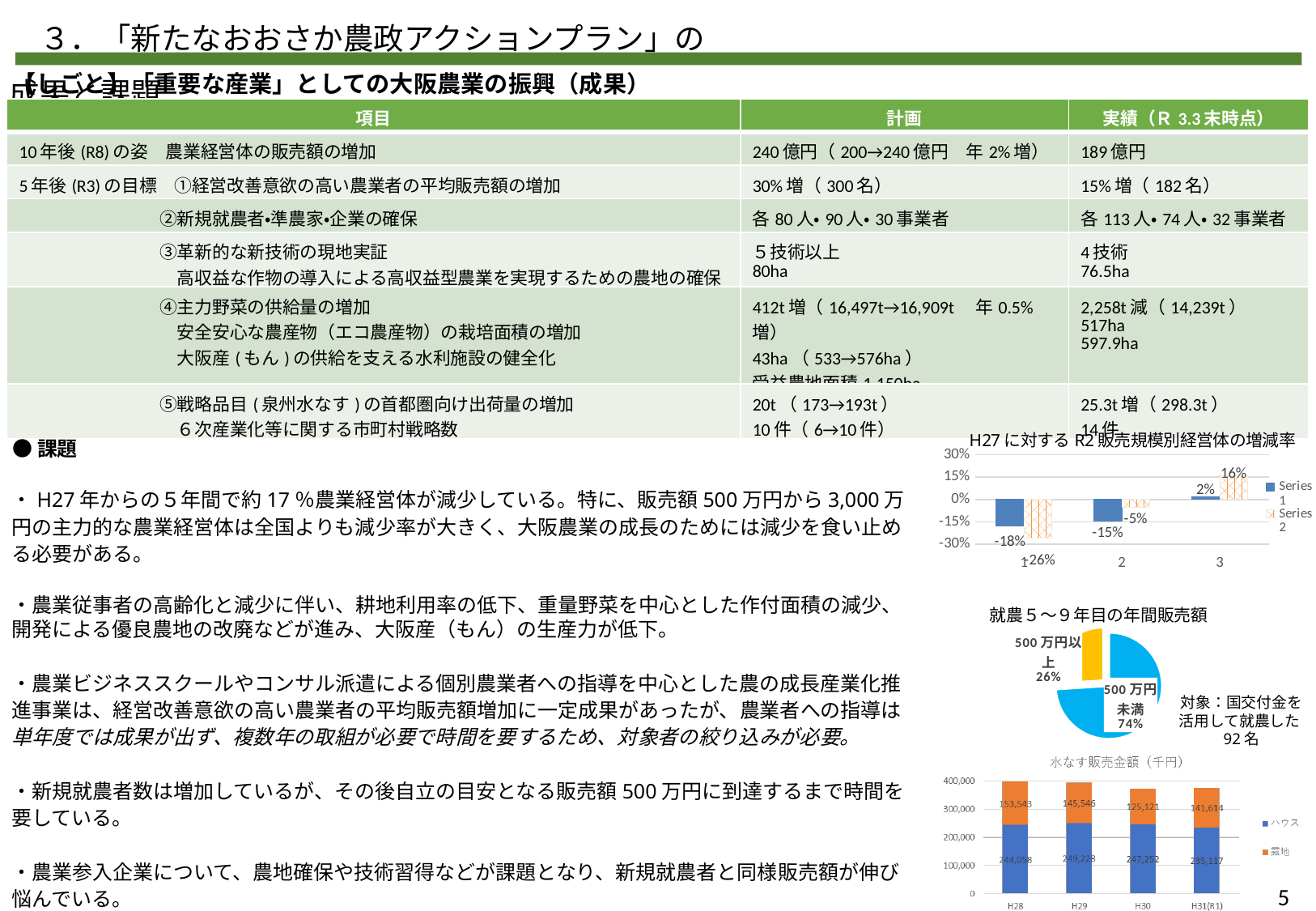
In the chart titled 「H27に対するR2販売規模別経営体の増減率」, what is the Series 1 value for category 1? -18% In the chart titled 「H27に対するR2販売規模別経営体の増減率」, what is the Series 2 value for category 3? 16% In the chart titled 「水なす販売金額（千円）」, which year has the highest 露地 value? H28 In the pie chart titled 「就農5～9年目の年間販売額」, what share is 500万円以上? 26% In the pie chart titled 「就農5～9年目の年間販売額」, what share is 500万円未満? 74% In the chart titled 「水なす販売金額（千円）」, what is the ハウス value for H29? 249,228 In the chart titled 「水なす販売金額（千円）」, how many years are shown on the x axis? 4 What kind of chart is 「就農5～9年目の年間販売額」? Pie chart In the chart titled 「H27に対するR2販売規模別経営体の増減率」, how many series does the legend list? 2 In the chart titled 「水なす販売金額（千円）」, what is the 露地 value for H30? 125,121 In the chart titled 「H27に対するR2販売規模別経営体の増減率」, which category has the lowest Series 2 value? 1 In the chart titled 「H27に対するR2販売規模別経営体の増減率」, what is the difference between the Series 1 and Series 2 values for category 2? 10 percentage points